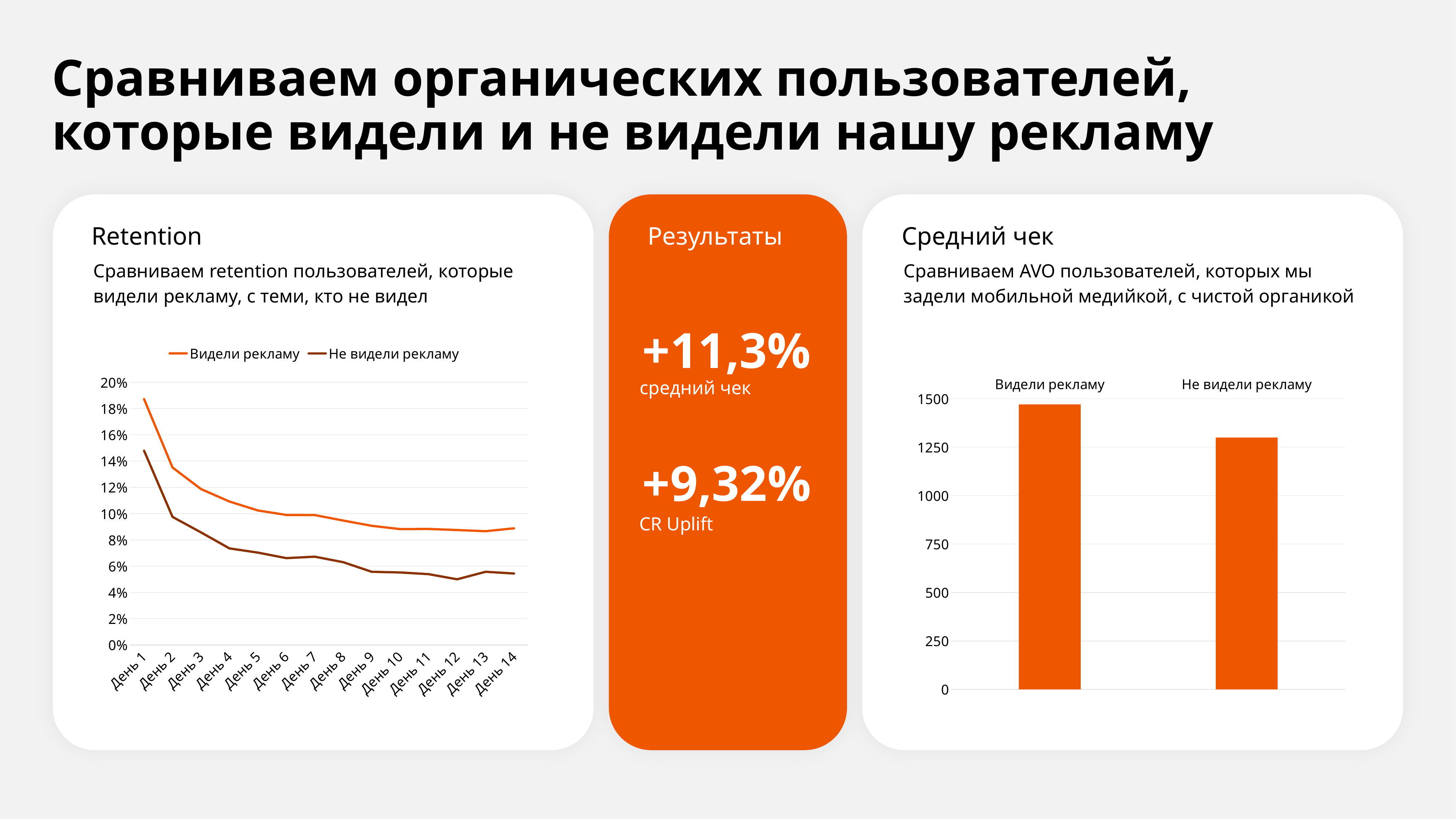
In the Retention chart, what are the two legend entries? Видели рекламу, Не видели рекламу In the Средний чек chart, is the value for Не видели рекламу greater or less than 1000? greater In the Retention chart, is the value for Не видели рекламу at День 14 greater or less than 8%? less In the Retention chart, is the value for Видели рекламу at День 1 greater or less than 16%? greater What kind of chart is the Средний чек chart on the right? bar chart In the Retention chart, how many series does the legend list? 2 In the Средний чек chart, which bar is highest? Видели рекламу In the Retention chart, which series is higher at День 1: Видели рекламу or Не видели рекламу? Видели рекламу What kind of chart is the Retention chart on the left? line chart In the Retention chart, does the Видели рекламу line rise or fall from День 1 to День 14? fall In the Средний чек chart, how many bars are there? 2 In the Retention chart, how many days are plotted along the x axis? 14